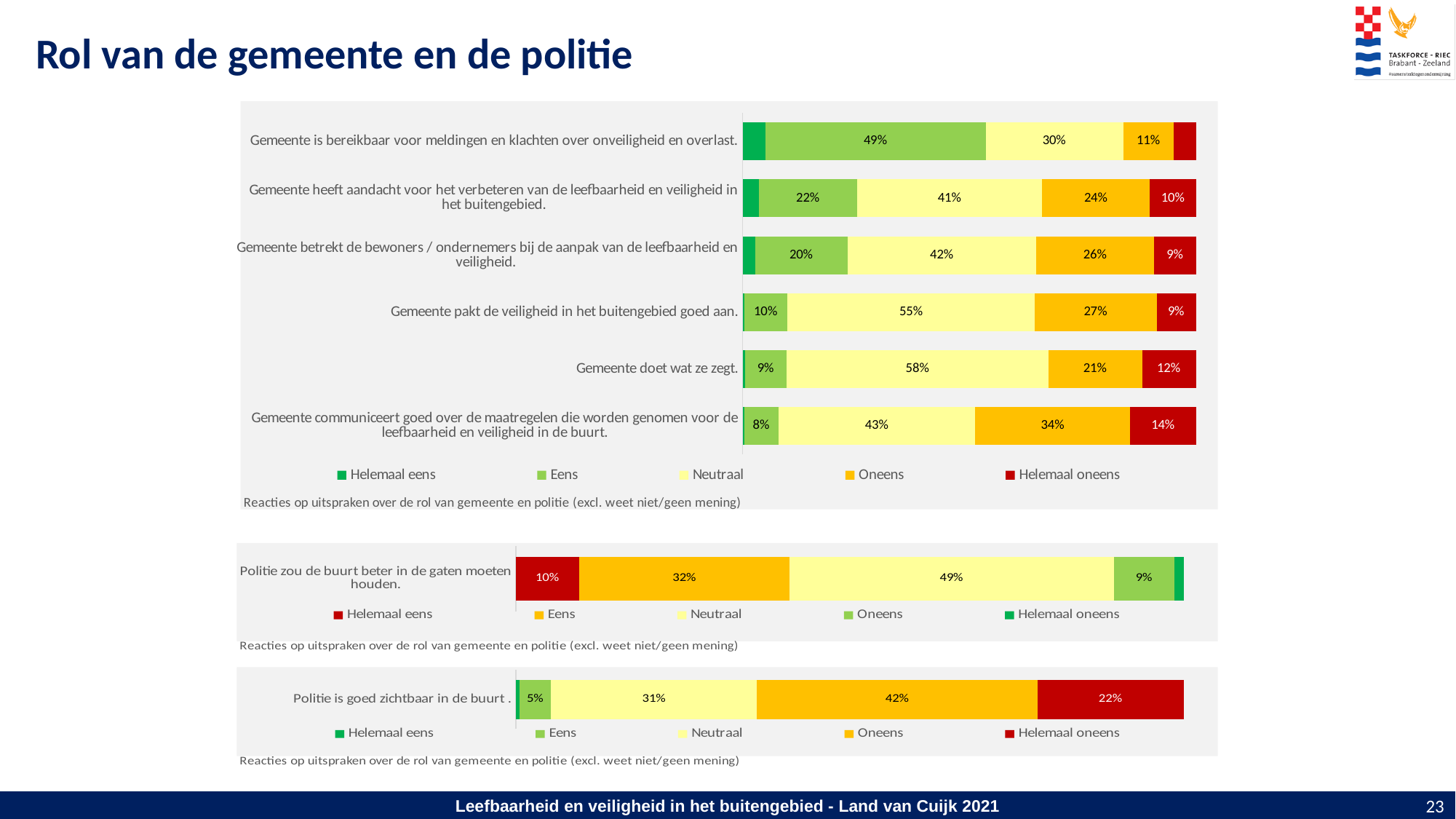
In the middle chart ('Politie zou de buurt beter in de gaten moeten houden.'), what percentage answered 'Neutraal'? 49% In the top chart, what is the 'Eens' percentage for 'Gemeente is bereikbaar voor meldingen en klachten over onveiligheid en overlast.'? 49% In the bottom chart ('Politie is goed zichtbaar in de buurt .'), what percentage answered 'Helemaal oneens'? 22% How many answer categories does the legend of the top chart list? 5 In the bottom chart ('Politie is goed zichtbaar in de buurt .'), which labelled answer category has the smallest share? Eens In the top chart, how much higher is the 'Oneens' percentage for 'Gemeente communiceert goed over de maatregelen...' than for 'Gemeente doet wat ze zegt.'? 13% In the top chart, which statement has the highest 'Neutraal' percentage? Gemeente doet wat ze zegt. In the top chart, which statement has the highest 'Helemaal oneens' percentage? Gemeente communiceert goed over de maatregelen die worden genomen voor de leefbaarheid en veiligheid in de buurt. What type of chart is used on this slide? Stacked bar chart In the top chart, what percentage of respondents answered 'Neutraal' to 'Gemeente doet wat ze zegt.'? 58% In the top chart, which statement has a larger 'Eens' share: 'Gemeente heeft aandacht voor het verbeteren van de leefbaarheid en veiligheid in het buitengebied.' or 'Gemeente betrekt de bewoners / ondernemers bij de aanpak van de leefbaarheid en veiligheid.'? Gemeente heeft aandacht voor het verbeteren van de leefbaarheid en veiligheid in het buitengebied. How many statements are shown in the top chart? 6